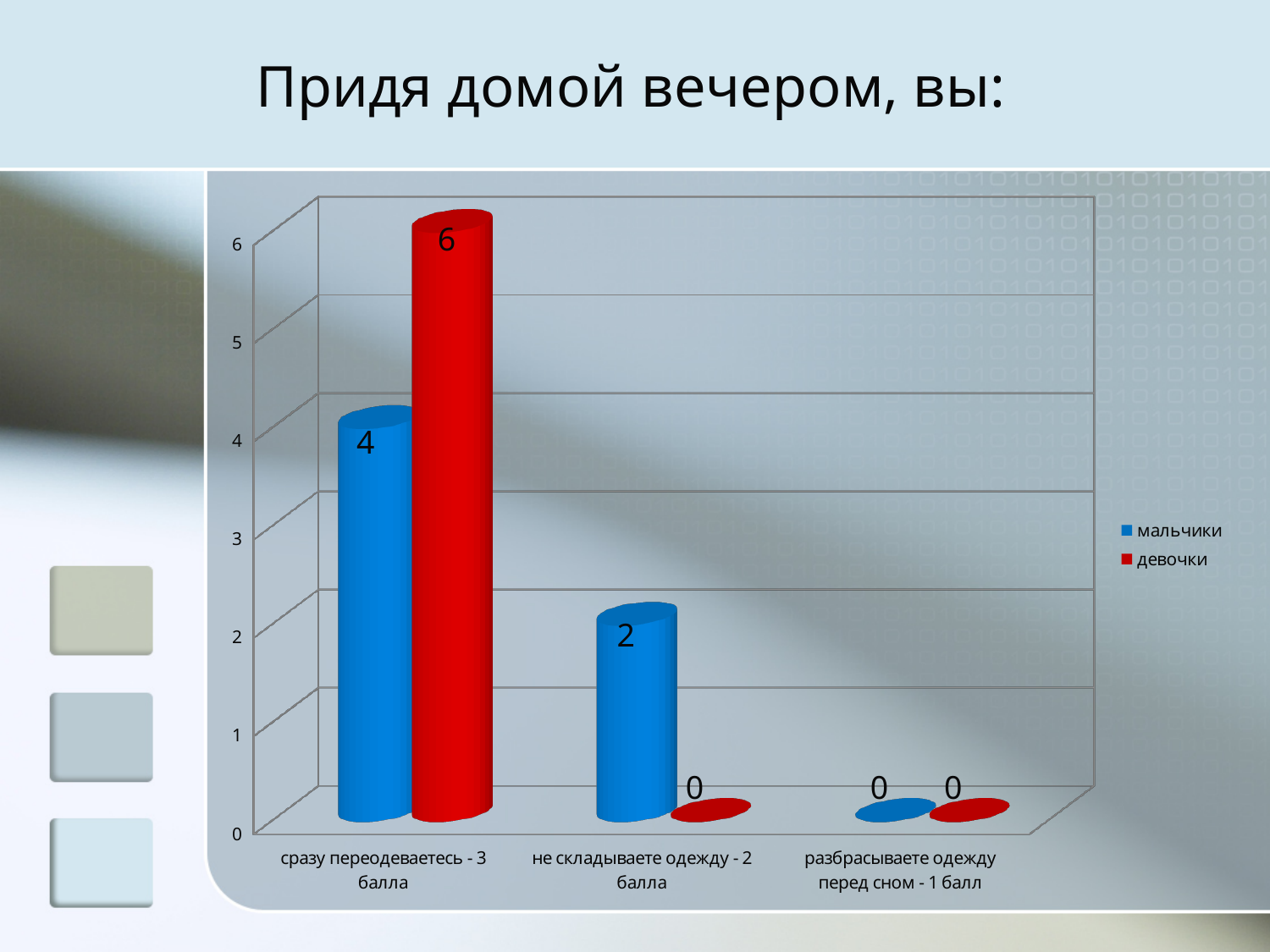
Which category has the highest value for девочки? сразу переодеваетесь - 3 балла What is the value for девочки in the category 'разбрасываете одежду перед сном - 1 балл'? 0 What is the value for мальчики in the category 'не складываете одежду - 2 балла'? 2 What kind of chart is shown on the slide? bar chart How many categories are shown on the x axis of the chart? 3 What is the value for мальчики in the category 'сразу переодеваетесь - 3 балла'? 4 What is the value for девочки in the category 'сразу переодеваетесь - 3 балла'? 6 Which category has the lowest value for мальчики? разбрасываете одежду перед сном - 1 балл In the category 'не складываете одежду - 2 балла', which series has the larger value, мальчики or девочки? мальчики How many series does the chart legend list? 2 Which colour represents the series девочки in the chart? red What is the difference between the девочки and мальчики values in the category 'сразу переодеваетесь - 3 балла'? 2